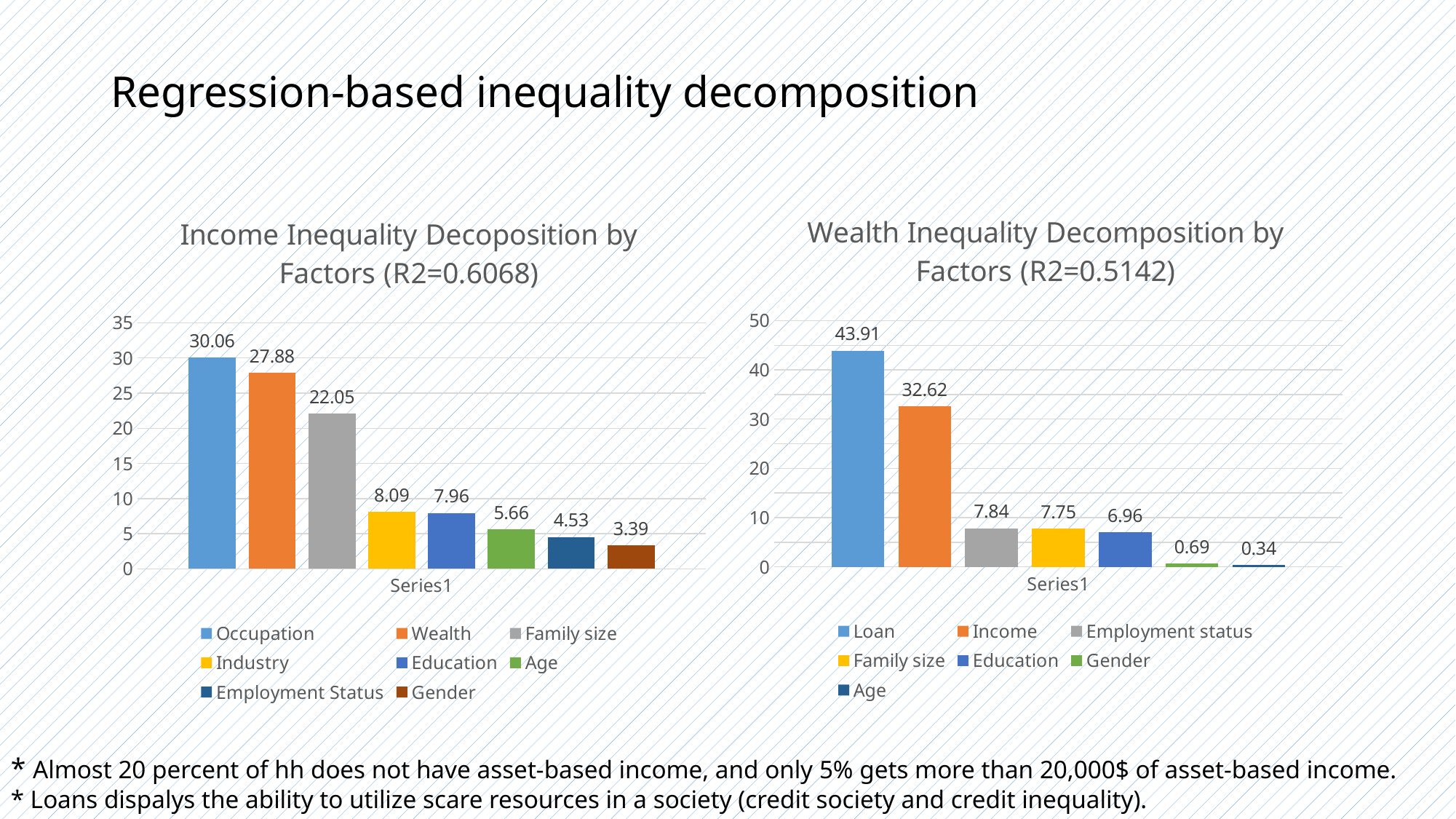
In the Income Inequality Decoposition chart, what is the difference between the values for Occupation and Wealth? 2.18 In the Income Inequality Decoposition chart, which is larger, the value for Industry or the value for Age? Industry In the Wealth Inequality Decomposition chart, what is the value for Loan? 43.91 In the Income Inequality Decoposition chart, what is the value for Family size? 22.05 How many entries does the legend of the Wealth Inequality Decomposition chart list? 7 In the Wealth Inequality Decomposition chart, what is the difference between the values for Loan and Income? 11.29 In the Wealth Inequality Decomposition chart, what is the value for Education? 6.96 In the Wealth Inequality Decomposition chart, which factor has the lowest value? Age In the Income Inequality Decoposition chart, which factor has the lowest value? Gender What kind of chart is the Income Inequality Decoposition chart? Bar chart In the Wealth Inequality Decomposition chart, which factor has the highest value? Loan In the Income Inequality Decoposition chart, what is the value for Occupation? 30.06